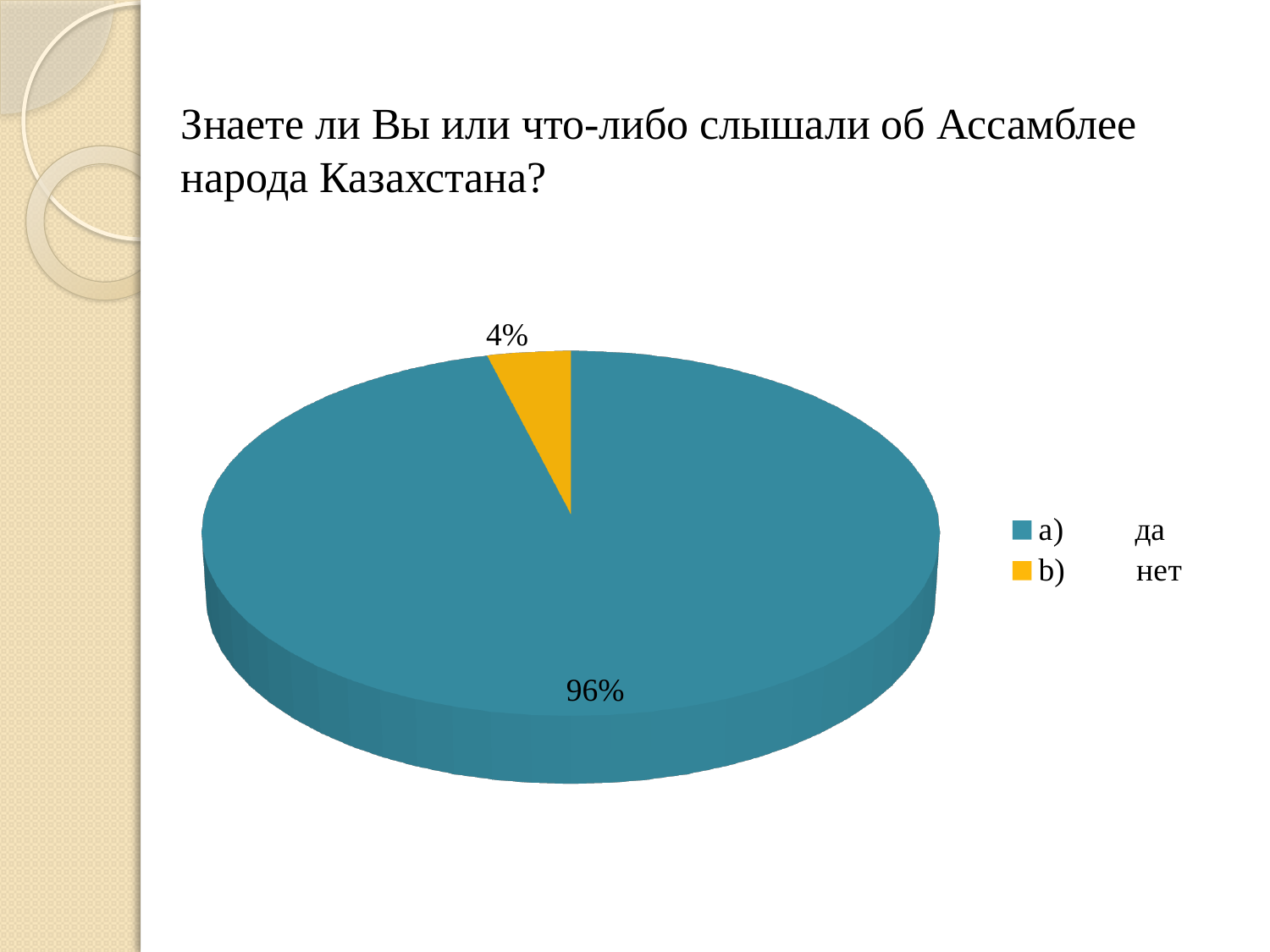
Which category has the largest slice of the pie? a) да What is the difference in percentage points between the "да" slice and the "нет" slice? 92 What share of the pie does "a) да" take? 96% What kind of chart is shown on the slide? pie chart What share of the pie does "b) нет" take? 4% Which is larger, the "да" slice or the "нет" slice? да How many slices does the pie chart have? 2 Which category has the smallest slice of the pie? b) нет How many entries does the legend list? 2 What question is the chart answering, according to the slide title? Знаете ли Вы или что-либо слышали об Ассамблее народа Казахстана? What colour is the slice for "b) нет"? yellow